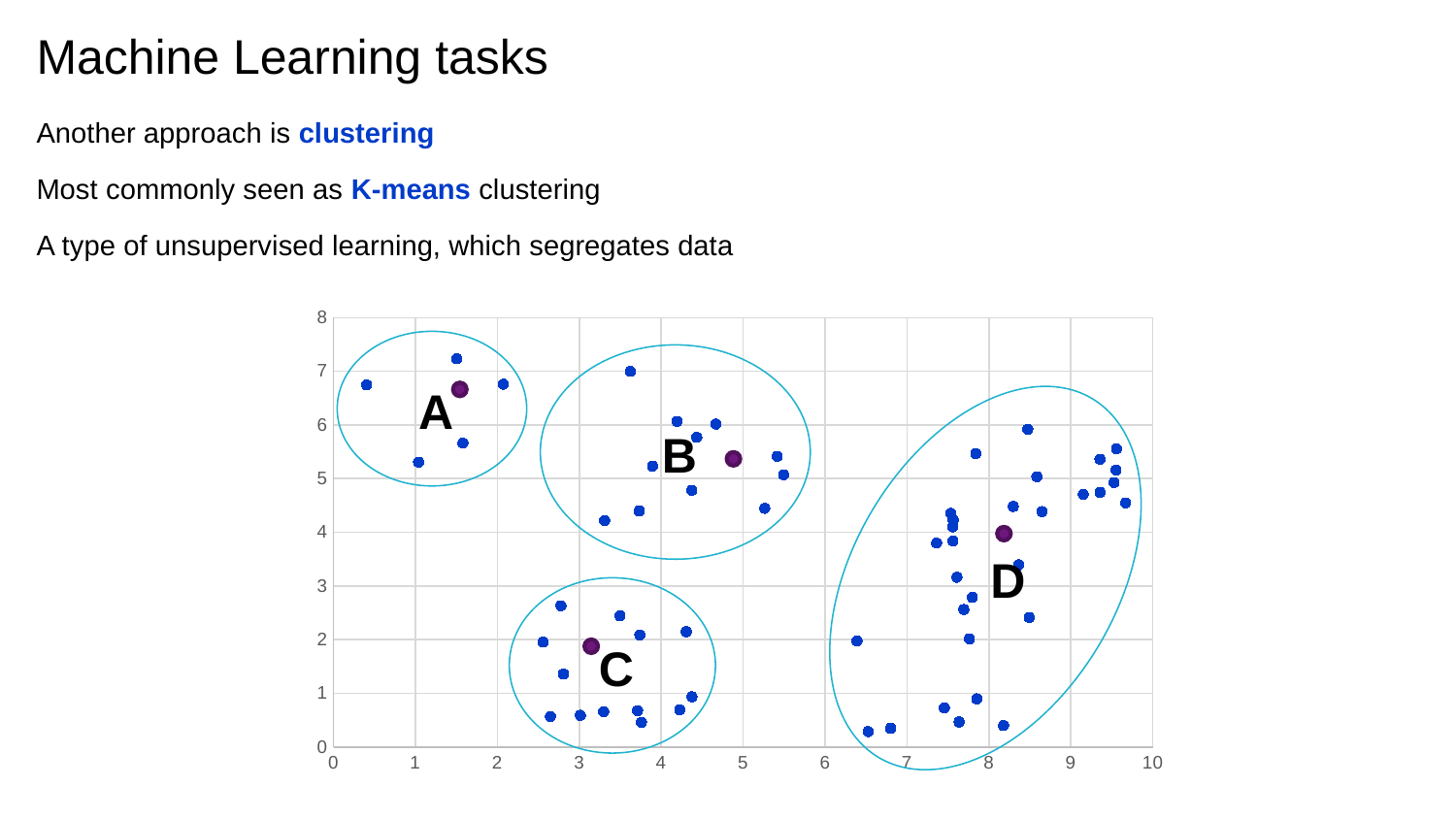
What is the maximum value shown on the x axis? 10 What are the labels of the clusters on the chart? A, B, C, D Is the y value of cluster A's centroid greater or less than 6? greater Which cluster contains the fewest data points? A Which cluster contains the most data points? D What kind of chart is shown on the slide? scatter chart Which cluster's centroid is furthest to the right on the x axis? D Which cluster's centroid has the lowest y value? C How many clusters are circled and labelled on the chart? 4 Is the x value of cluster B's centroid greater or less than 4? greater Is the y value of cluster C's centroid greater or less than 3? less Which cluster's centroid has the highest y value? A